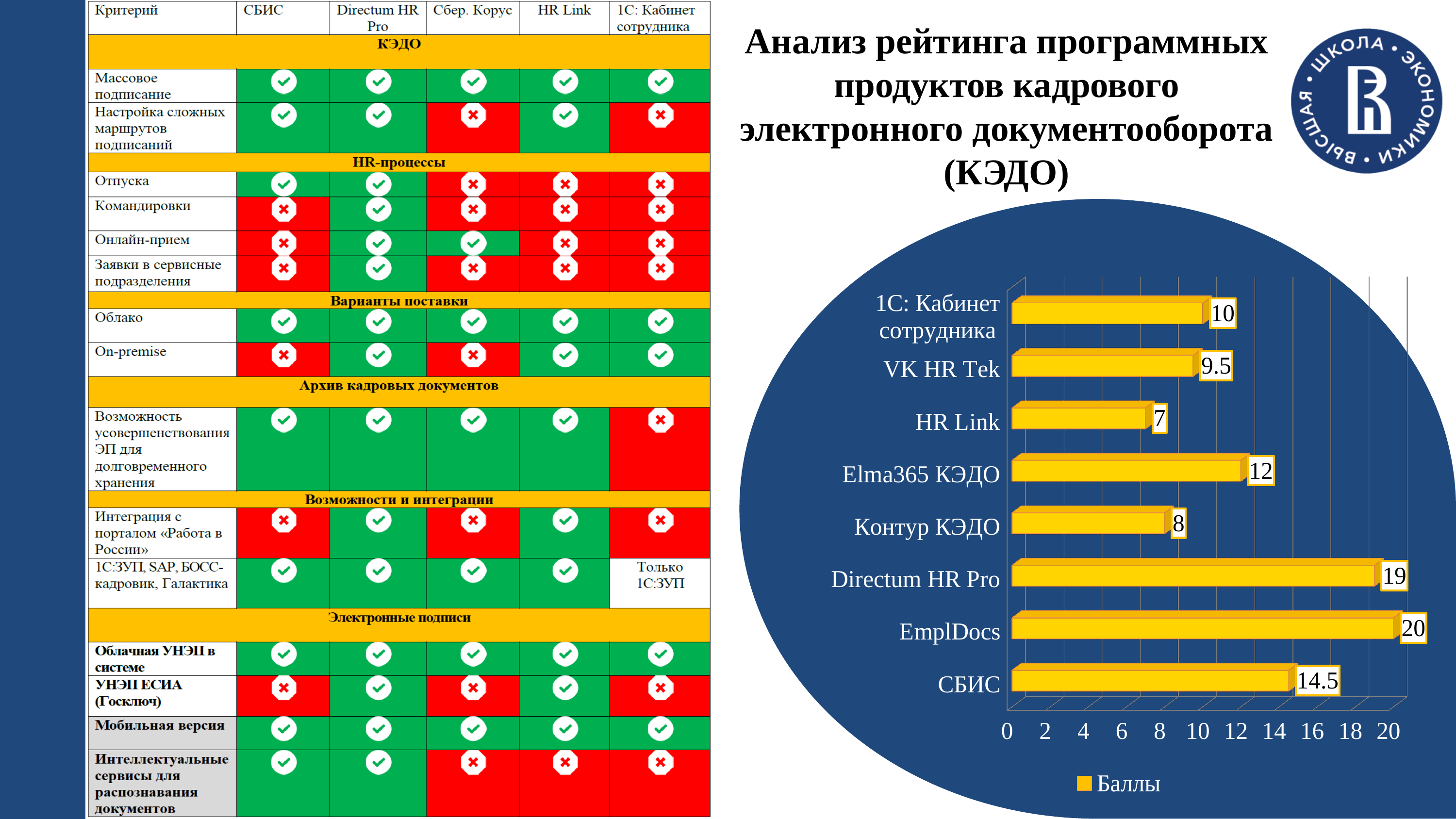
Which product has the highest score? EmplDocs What is the difference between the values for Directum HR Pro and Elma365 КЭДО? 7 What is the value for EmplDocs? 20 Which is larger, the value for 1С: Кабинет сотрудника or the value for HR Link? 1С: Кабинет сотрудника What is the value for Контур КЭДО? 8 How many products are shown in the chart? 8 What is the value for VK HR Tek? 9.5 Which product has the lowest score? HR Link What type of chart is shown on the slide? bar chart How many series does the legend list? 1 What is the name of the series in the legend? Баллы What is the value for СБИС? 14.5